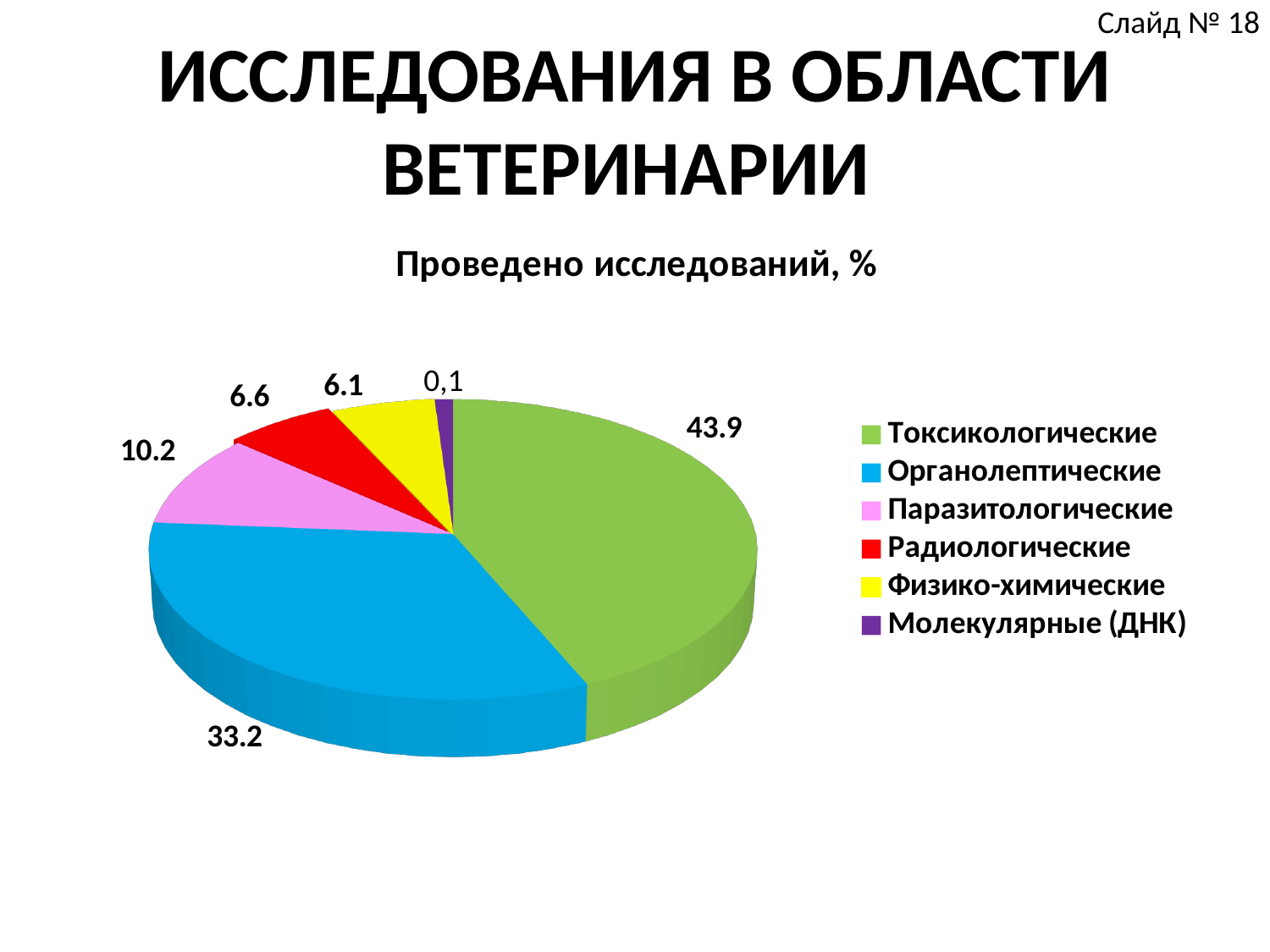
Which category has the largest share of the pie? Токсикологические What type of chart is shown on the slide? Pie chart What is the value for Физико-химические? 6.1 Which category has the smallest share of the pie? Молекулярные (ДНК) What is the difference between the values for Токсикологические and Органолептические? 10.7 What is the title of the chart? Проведено исследований, % What is the value for Токсикологические? 43.9 What is the value for Органолептические? 33.2 What is the value for Паразитологические? 10.2 What is the value for Радиологические? 6.6 What is the value for Молекулярные (ДНК)? 0,1 How many categories does the legend list? 6